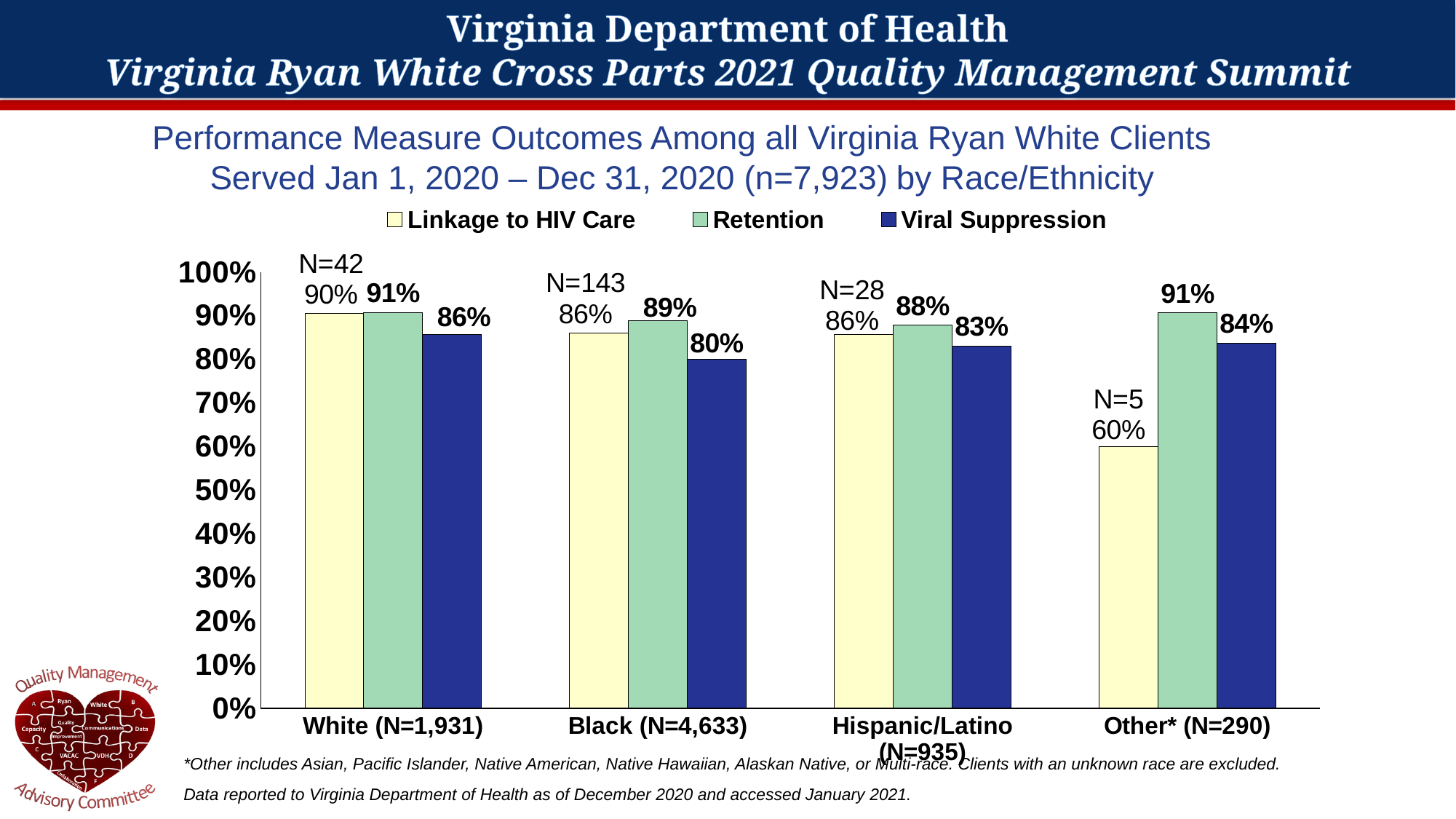
Which race/ethnicity group has the lowest Linkage to HIV Care value? Other* (N=290) What is the N value printed above the Linkage to HIV Care bar for Hispanic/Latino (N=935)? N=28 What is the difference between the Retention and Viral Suppression values for Black (N=4,633)? 9% What is the Linkage to HIV Care value for Other* (N=290)? 60% What is the Viral Suppression value for White (N=1,931)? 86% What is the Retention value for Black (N=4,633)? 89% What kind of chart is shown on the slide? Bar chart How many race/ethnicity categories are shown on the x axis? 4 How many series does the legend list? 3 Which is larger, the Viral Suppression value for White (N=1,931) or for Hispanic/Latino (N=935)? White (N=1,931) Which series is shown in dark blue in the legend? Viral Suppression Which race/ethnicity group has the lowest Viral Suppression value? Black (N=4,633)